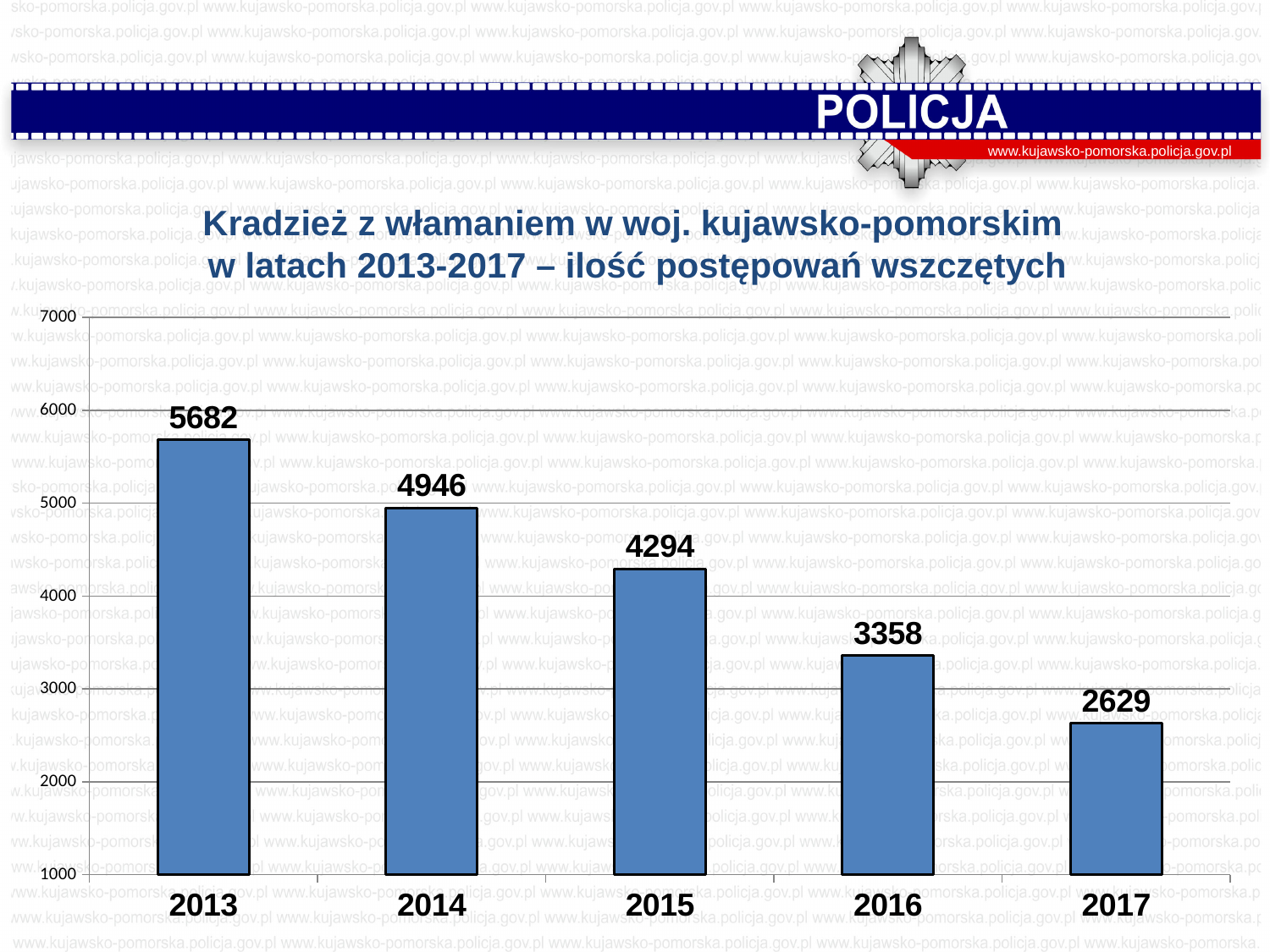
What value is shown for 2017? 2629 Is the value for 2016 greater or less than 3000? greater What is the difference between the values for 2014 and 2015? 652 How many years are shown on the chart? 5 What value is shown for 2015? 4294 Do the values rise or fall from 2013 to 2017? fall Which year has the lowest value? 2017 Which year has the highest value? 2013 What is the difference between the values for 2013 and 2017? 3053 What kind of chart is shown on the slide? bar chart Which is larger, the value for 2014 or the value for 2016? 2014 What was the number of initiated proceedings for burglary in 2013? 5682